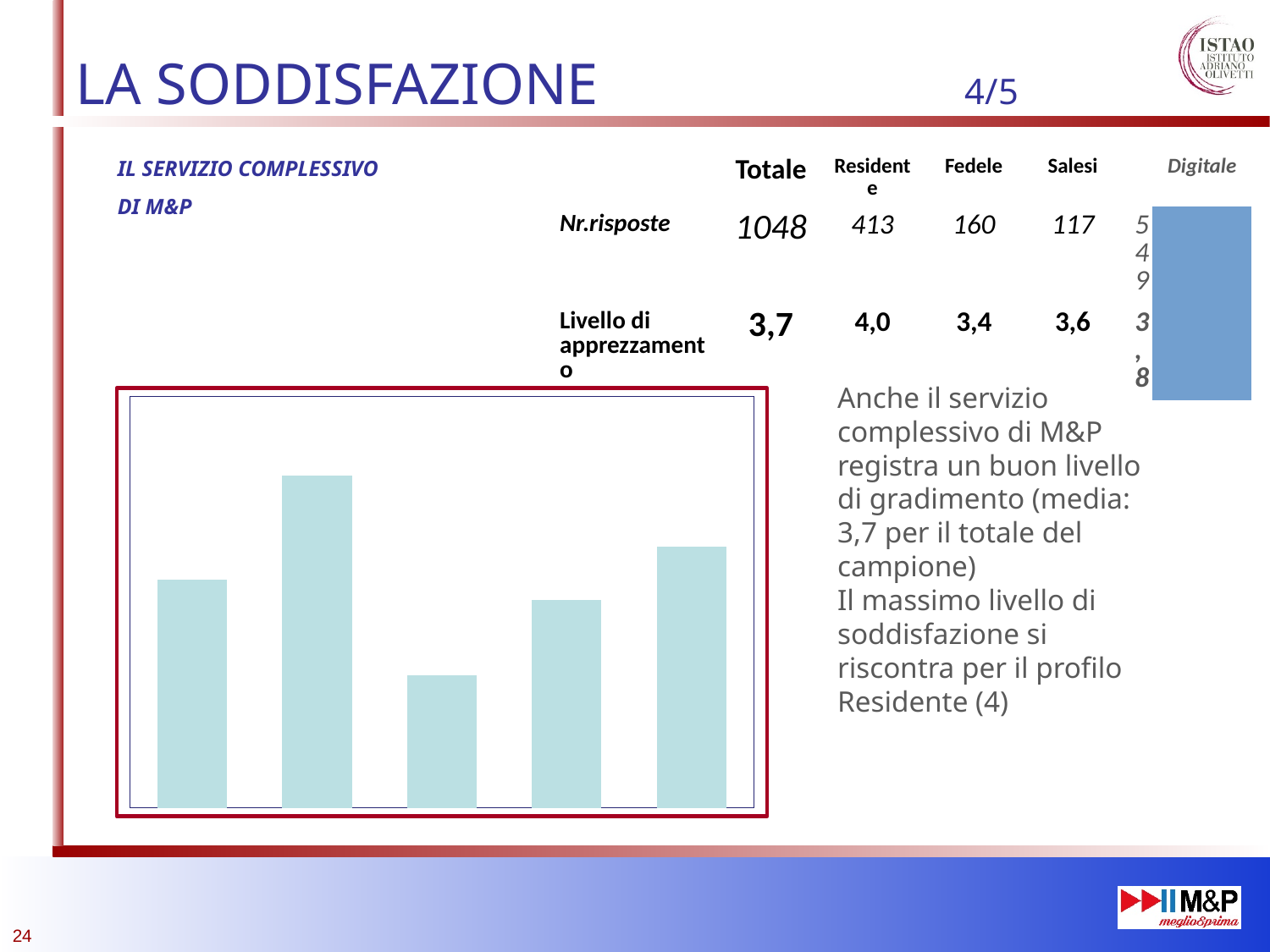
Counting from the left, which bar in the chart is the tallest? the second bar In the chart, is the fifth bar from the left taller or shorter than the first bar? taller In the chart, is the second bar from the left taller or shorter than the third bar? taller How many bars does the chart in the red-bordered box contain? 5 In the chart, is the fourth bar from the left taller or shorter than the third bar? taller Does the chart in the red-bordered box display a legend? No What kind of chart is shown in the red-bordered box on the slide? bar chart What colour are the bars in the chart? light blue Counting from the left, which bar in the chart is the shortest? the third bar